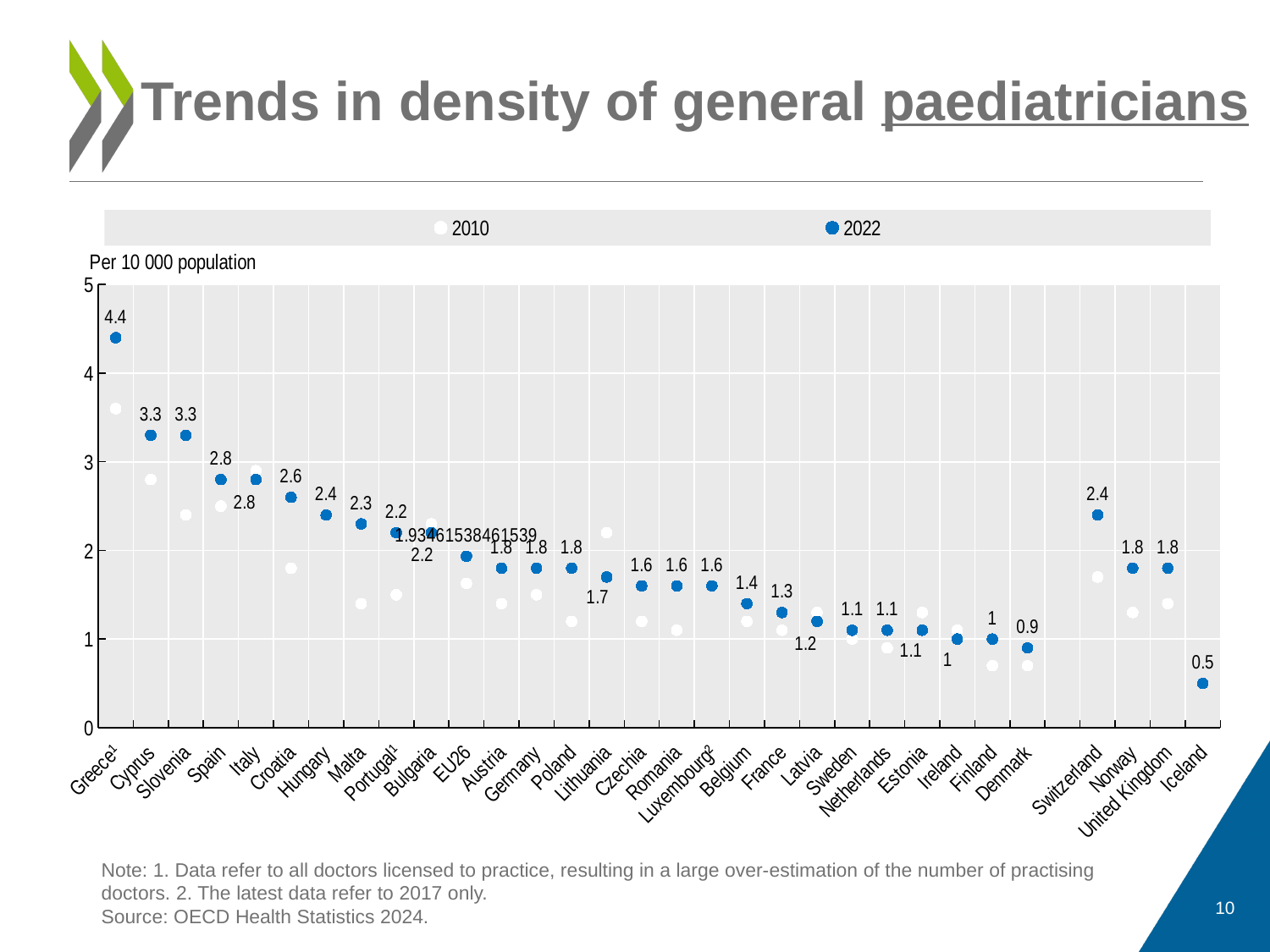
What unit is shown on the y axis? Per 10 000 population Which country has the lowest 2022 value? Iceland How many series does the legend list? 2 Is the 2010 value for Malta greater or less than 2? less Which has the larger 2022 value, Spain or Croatia? Spain What is the difference between the 2022 values for Greece and Iceland? 3.9 What is the 2022 value for Switzerland? 2.4 Which country has the highest 2022 value? Greece What is the 2022 value for Greece? 4.4 How many countries/regions are shown on the x axis? 31 What kind of chart is shown on the slide? dot plot Is the 2010 value for Greece greater or less than 3? greater